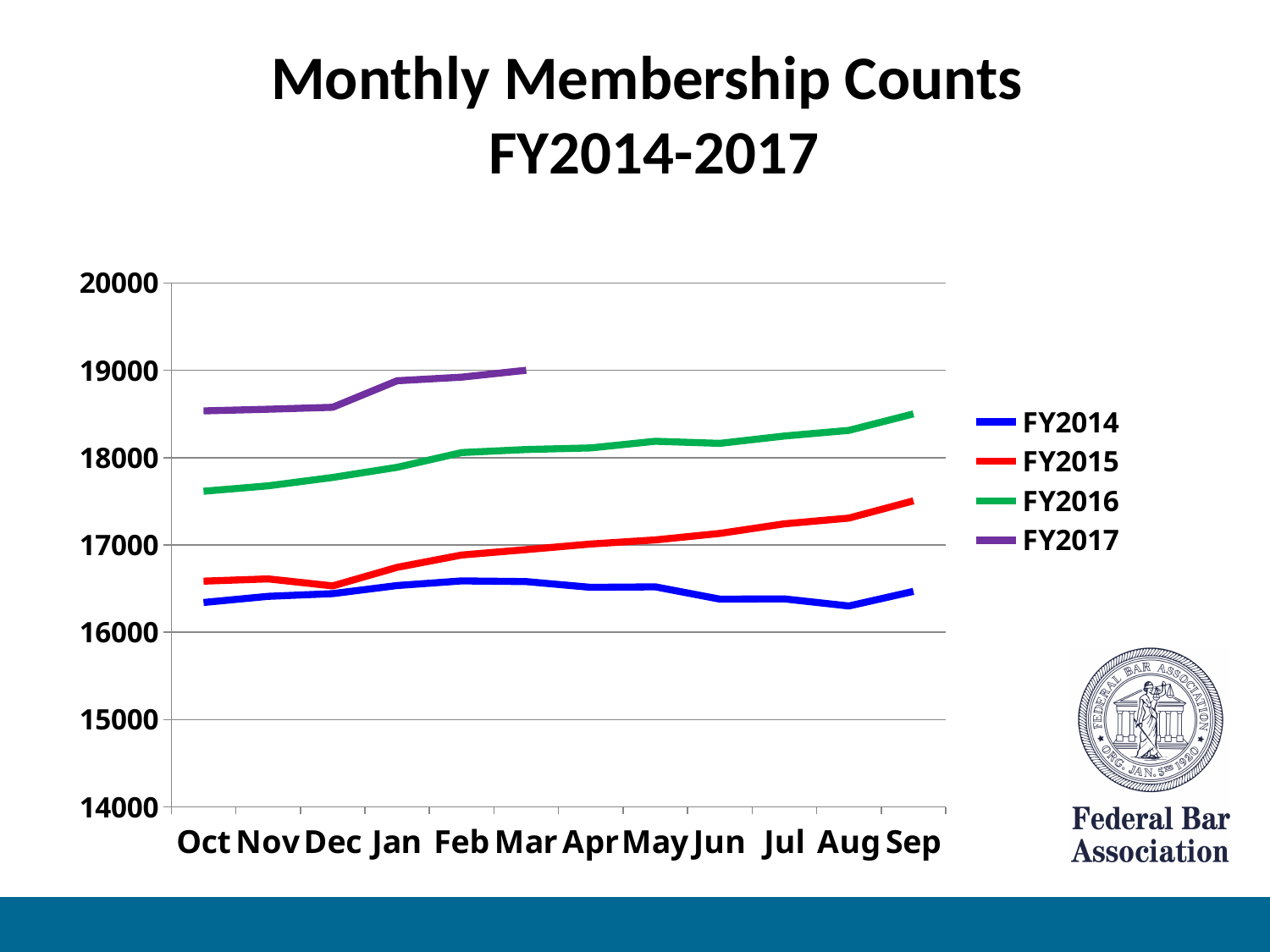
How many series does the legend list? 4 Do the FY2016 values generally rise or fall from Oct to Sep? rise What kind of chart is shown on the slide? line chart Is the FY2014 value for Sep greater or less than 17000? less Is the FY2015 value for Sep greater or less than 17000? greater Is the FY2017 value for Oct greater or less than 18000? greater Which fiscal year series has the lowest membership counts? FY2014 How many months are shown along the x axis? 12 Which is larger in Oct, the FY2016 value or the FY2014 value? FY2016 What is the title of the chart? Monthly Membership Counts FY2014-2017 Which fiscal year series has the highest membership counts? FY2017